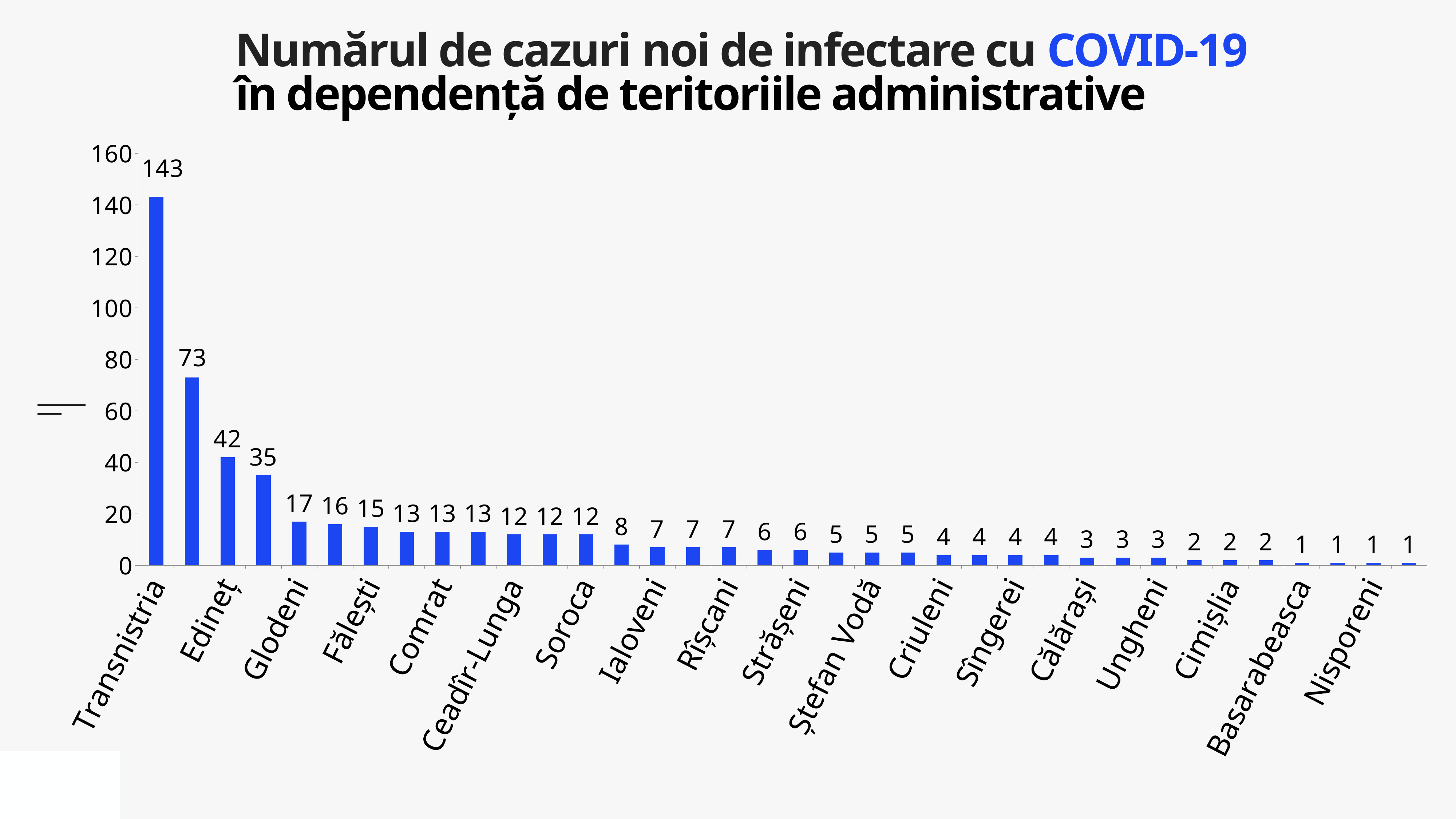
Is the value for Transnistria greater or less than 140? greater Which territory has the highest number of new COVID-19 cases? Transnistria Do the values rise or fall moving from left to right along the x axis? fall How many new cases are shown for Ștefan Vodă? 5 How many new cases are shown for Nisporeni? 1 What is the highest tick value shown on the vertical axis? 160 What type of chart is shown on the slide? bar chart What is the difference between the two tallest bars (143 and 73)? 70 How many new cases are shown for Comrat? 13 What is the smallest value shown on any bar in the chart? 1 Which has more new cases, Transnistria or Edineț? Transnistria How many new COVID-19 cases are shown for Transnistria? 143